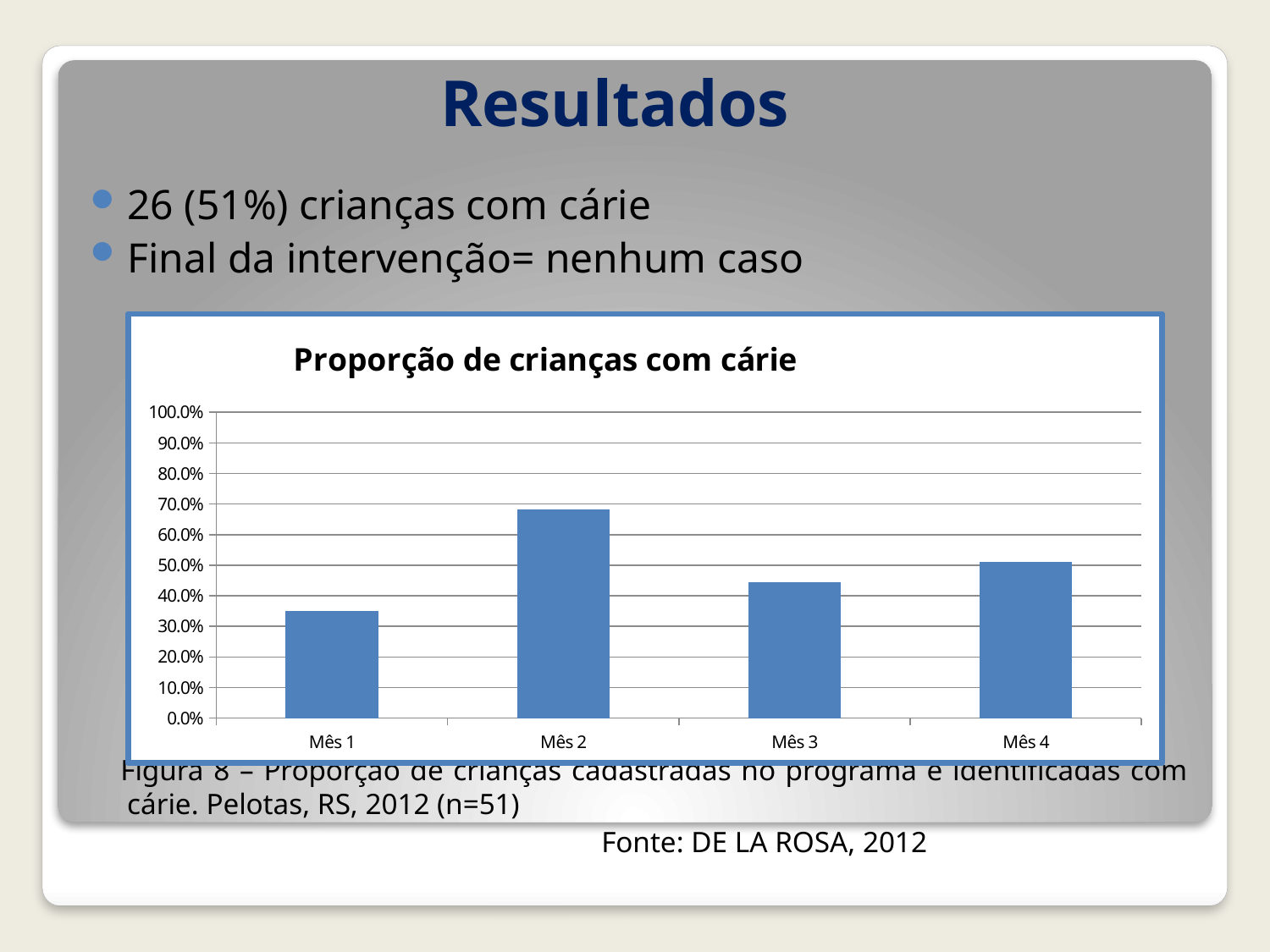
Which is larger, the value for Mês 2 or the value for Mês 3? Mês 2 Is the value for Mês 1 greater or less than 40.0%? less Is the value for Mês 4 greater or less than 40.0%? greater What kind of chart is shown on the slide? bar chart Is the value for Mês 3 greater or less than 50.0%? less How many categories (months) are plotted on the chart? 4 Which month has the highest proportion of children with caries? Mês 2 Does the value rise or fall from Mês 2 to Mês 3? fall Which month has the lowest proportion of children with caries? Mês 1 What is the title of the chart? Proporção de crianças com cárie Which is larger, the value for Mês 4 or the value for Mês 1? Mês 4